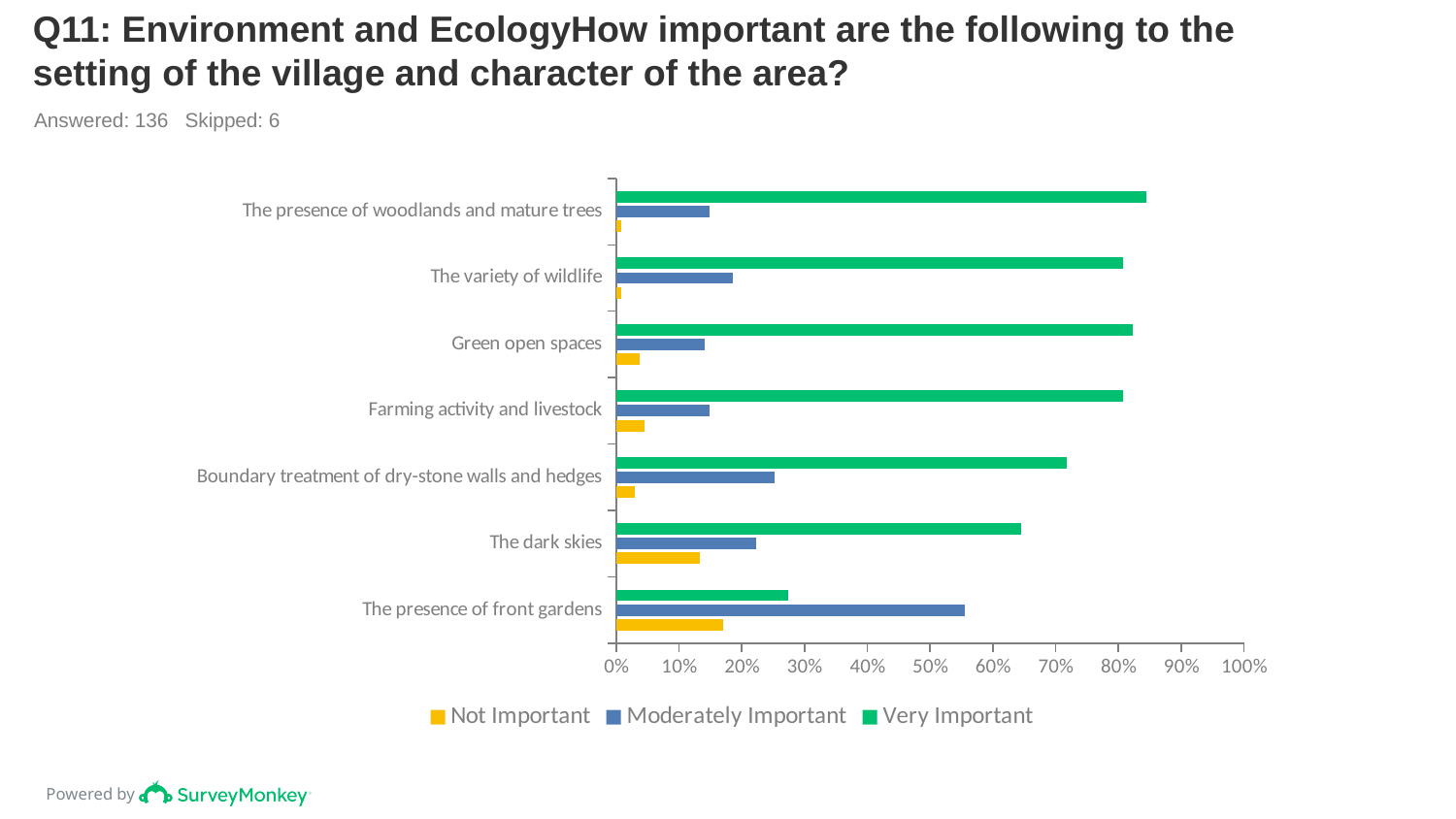
Which category has the highest Moderately Important value? The presence of front gardens Which has the larger Very Important value: The dark skies or Boundary treatment of dry-stone walls and hedges? Boundary treatment of dry-stone walls and hedges How many series does the legend list? 3 Is the Very Important value for The presence of front gardens greater or less than 30%? less Is the Moderately Important value for The presence of front gardens greater or less than 50%? greater Which colour represents the Very Important series in the legend? green Which category has the highest Not Important value? The presence of front gardens Is the Very Important value for The dark skies greater or less than 60%? greater How many categories are plotted on the chart? 7 Which category has the lowest Very Important value? The presence of front gardens What kind of chart is shown on the slide? bar chart